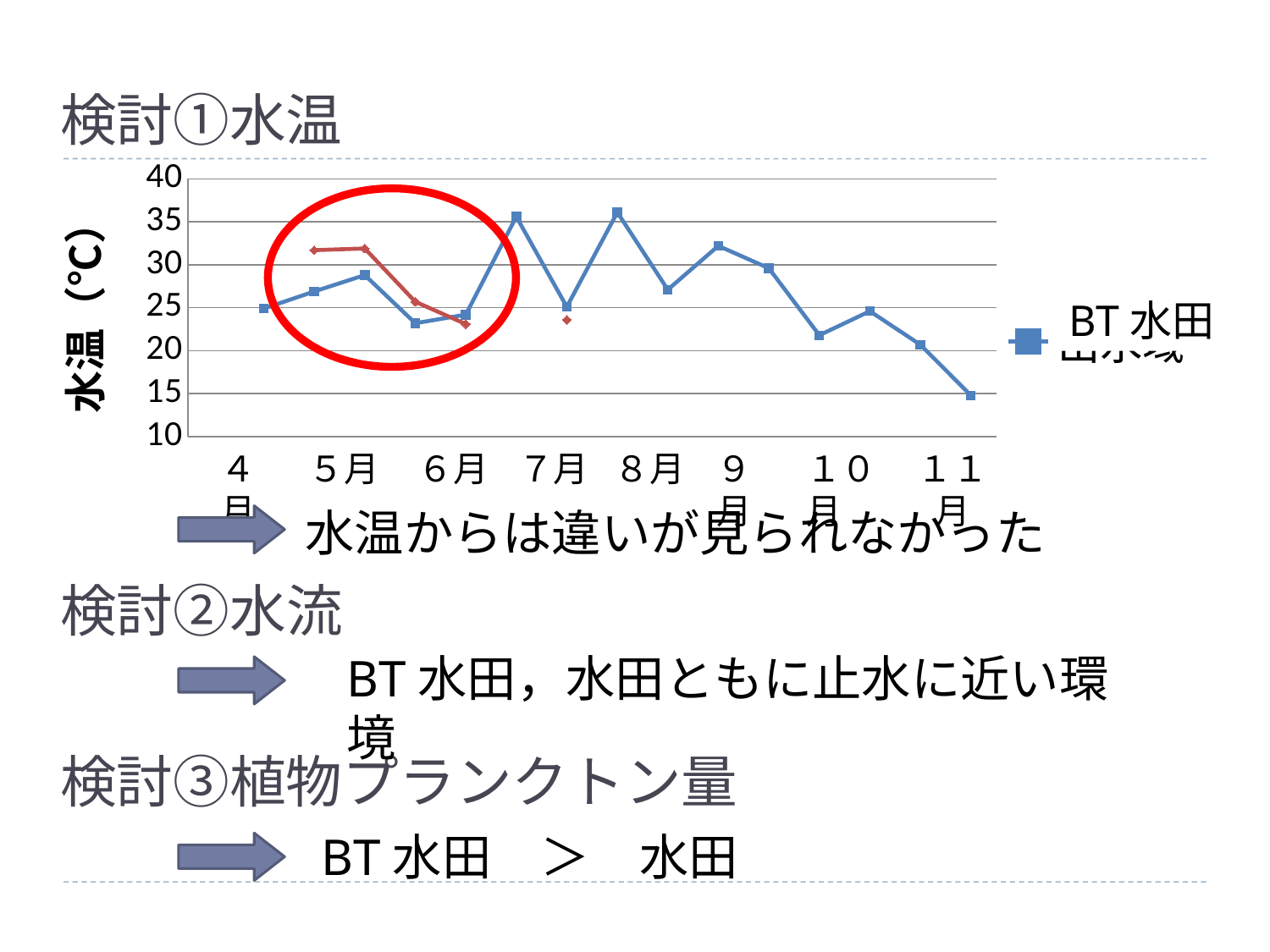
Is the highest BT水田 value, around 8月, greater or less than 30? greater At 5月, which series has the higher water temperature, the red series or BT水田? the red series What is the label on the vertical axis of the chart? 水温（℃） What kind of chart is shown on the slide? line chart Does the BT水田 series rise or fall from 9月 to 11月? fall How many month labels are shown along the x axis of the chart? 8 What is the highest tick value shown on the vertical axis? 40 At which month does the BT水田 series reach its lowest value? 11月 Is the first value of the red series, near 5月, greater or less than 30? greater Is the BT水田 value at 4月 greater or less than 30? less